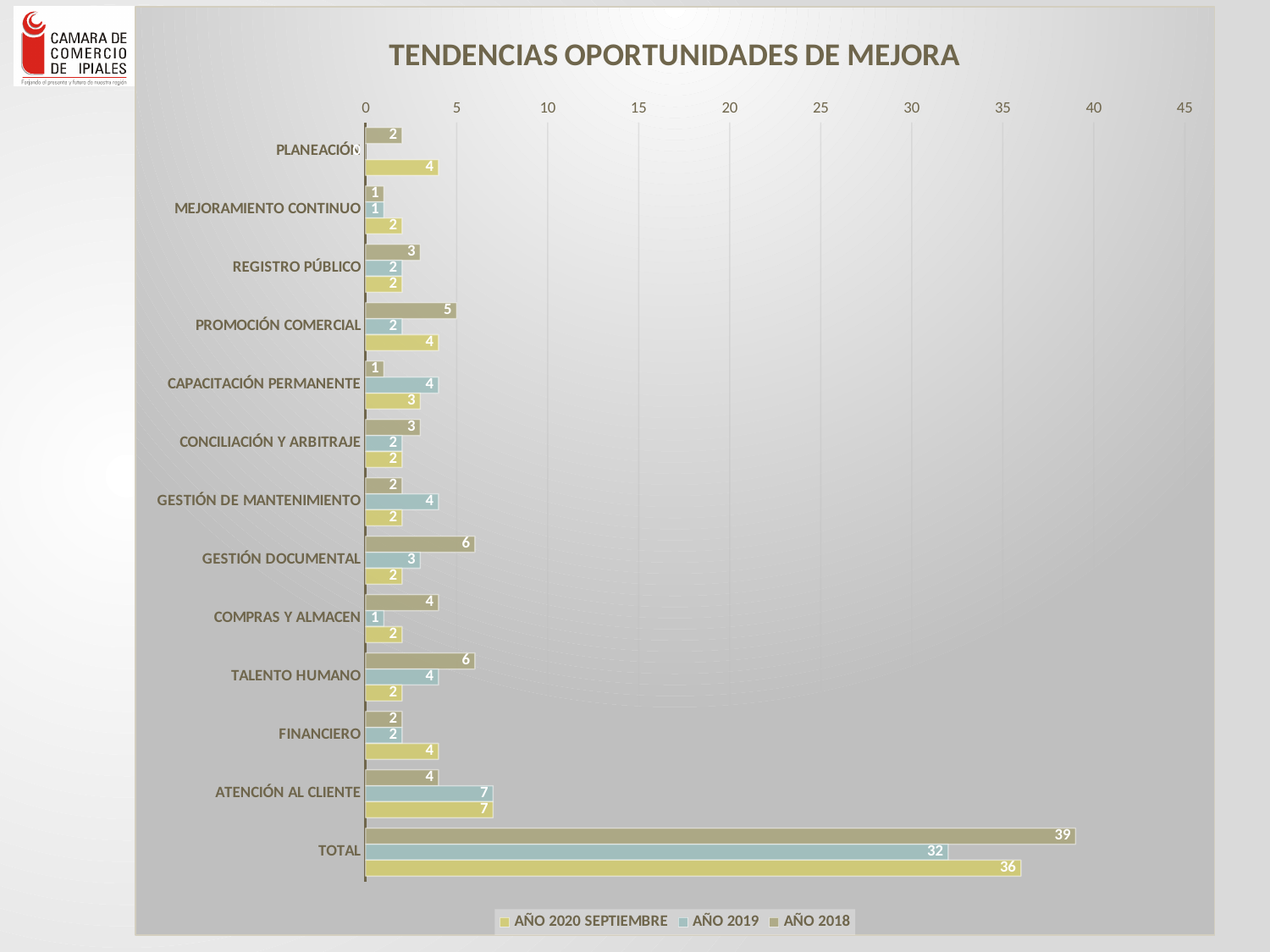
What type of chart is shown on the slide? bar chart What is the title of the chart? TENDENCIAS OPORTUNIDADES DE MEJORA Which is larger, the TOTAL for AÑO 2020 SEPTIEMBRE or the TOTAL for AÑO 2019? AÑO 2020 SEPTIEMBRE What is the TOTAL value for AÑO 2018? 39 How many series does the legend list? 3 Is the TOTAL value for AÑO 2018 greater or less than 35? greater How many categories are shown on the vertical axis, including TOTAL? 13 Excluding TOTAL, which category has the highest value for AÑO 2019? ATENCIÓN AL CLIENTE What is the difference between the TOTAL for AÑO 2018 and the TOTAL for AÑO 2019? 7 What is the value for GESTIÓN DOCUMENTAL in AÑO 2018? 6 What is the value for ATENCIÓN AL CLIENTE in AÑO 2020 SEPTIEMBRE? 7 What is the TOTAL value for AÑO 2019? 32